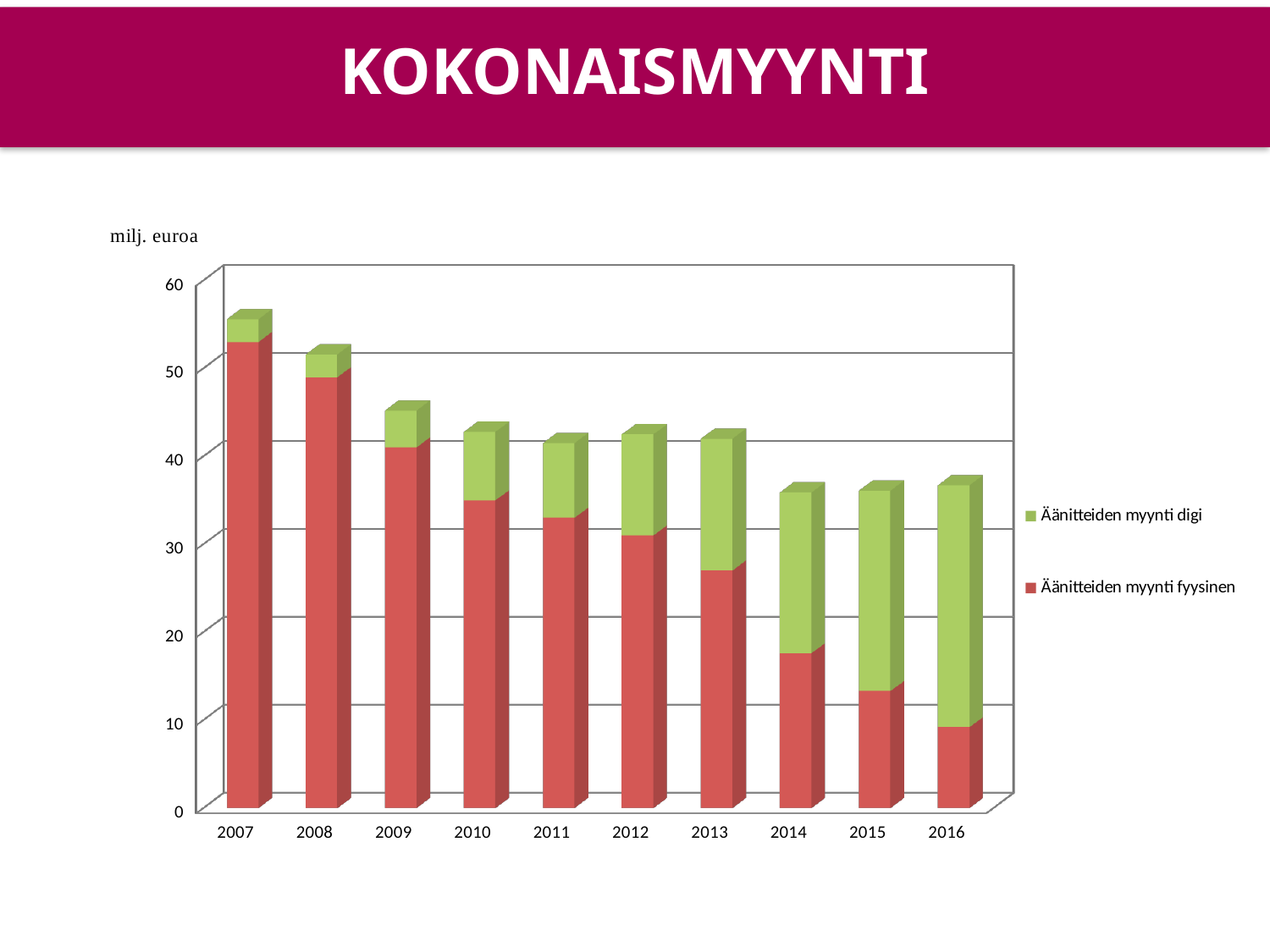
In which year is the value for Äänitteiden myynti fyysinen highest? 2007 What kind of chart is shown on the slide? Stacked bar chart Which is larger, the value for Äänitteiden myynti fyysinen in 2009 or in 2012? 2009 Is the value for Äänitteiden myynti fyysinen in 2016 greater or less than 20? less How many series does the legend list? 2 How many years are shown on the x axis? 10 In which year is the value for Äänitteiden myynti digi highest? 2016 Is the total stacked bar for 2007 greater or less than 50? greater Does the value for Äänitteiden myynti fyysinen rise or fall from 2007 to 2016? fall In which year is the value for Äänitteiden myynti fyysinen lowest? 2016 Is the value for Äänitteiden myynti fyysinen in 2007 greater or less than 50? greater What unit is shown above the y axis of the chart? milj. euroa